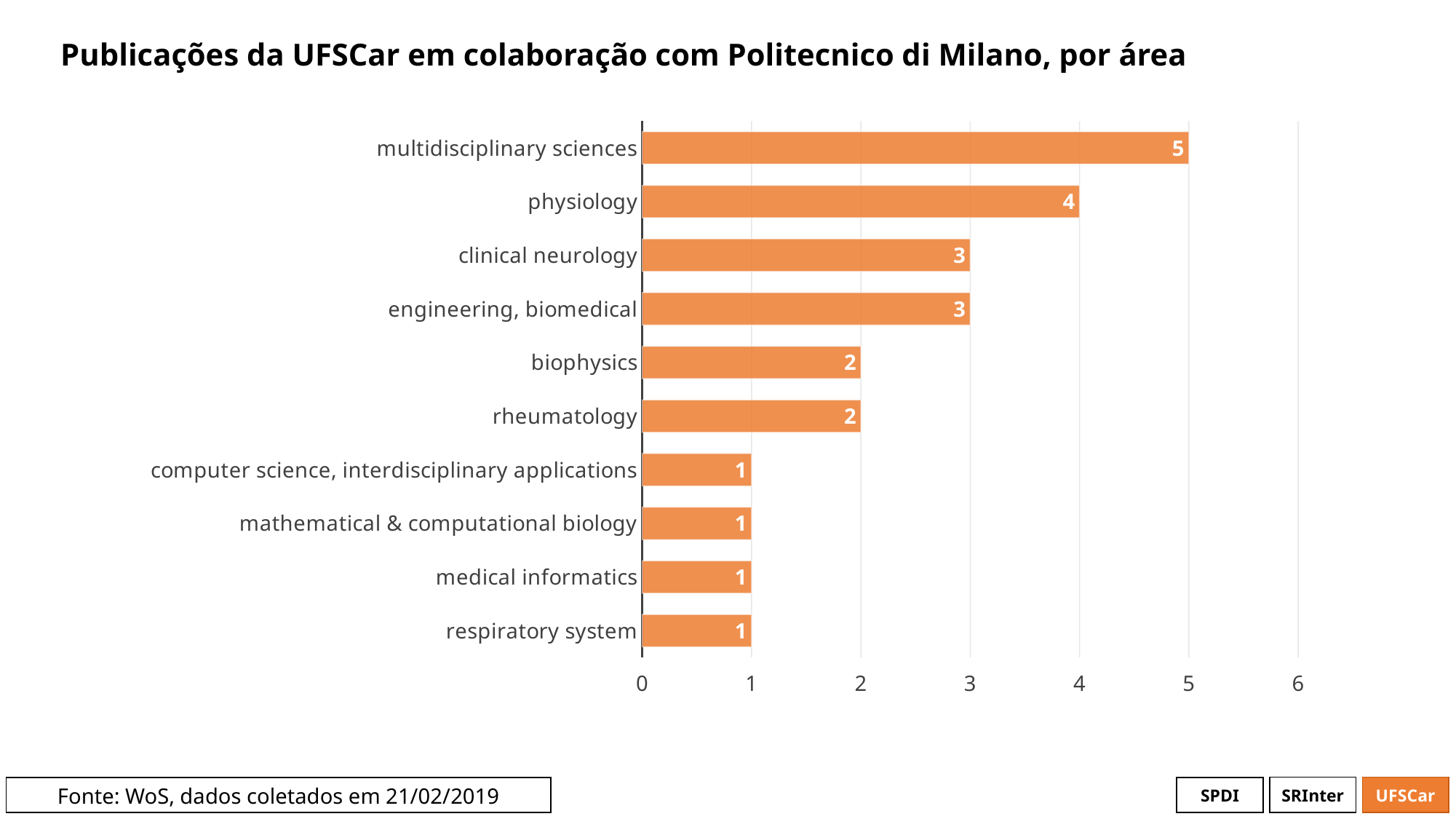
What is the value for physiology? 4 What is the difference between the values for clinical neurology and rheumatology? 1 What is the title of the chart? Publicações da UFSCar em colaboração com Politecnico di Milano, por área How many areas are shown in the chart? 10 What is the value for multidisciplinary sciences? 5 What is the value for biophysics? 2 Which area has the highest number of publications? multidisciplinary sciences What is the difference between the values for multidisciplinary sciences and physiology? 1 Which is larger, the value for physiology or the value for engineering, biomedical? physiology Is the value for multidisciplinary sciences greater or less than 3? greater What is the value for medical informatics? 1 What kind of chart is shown on the slide? bar chart